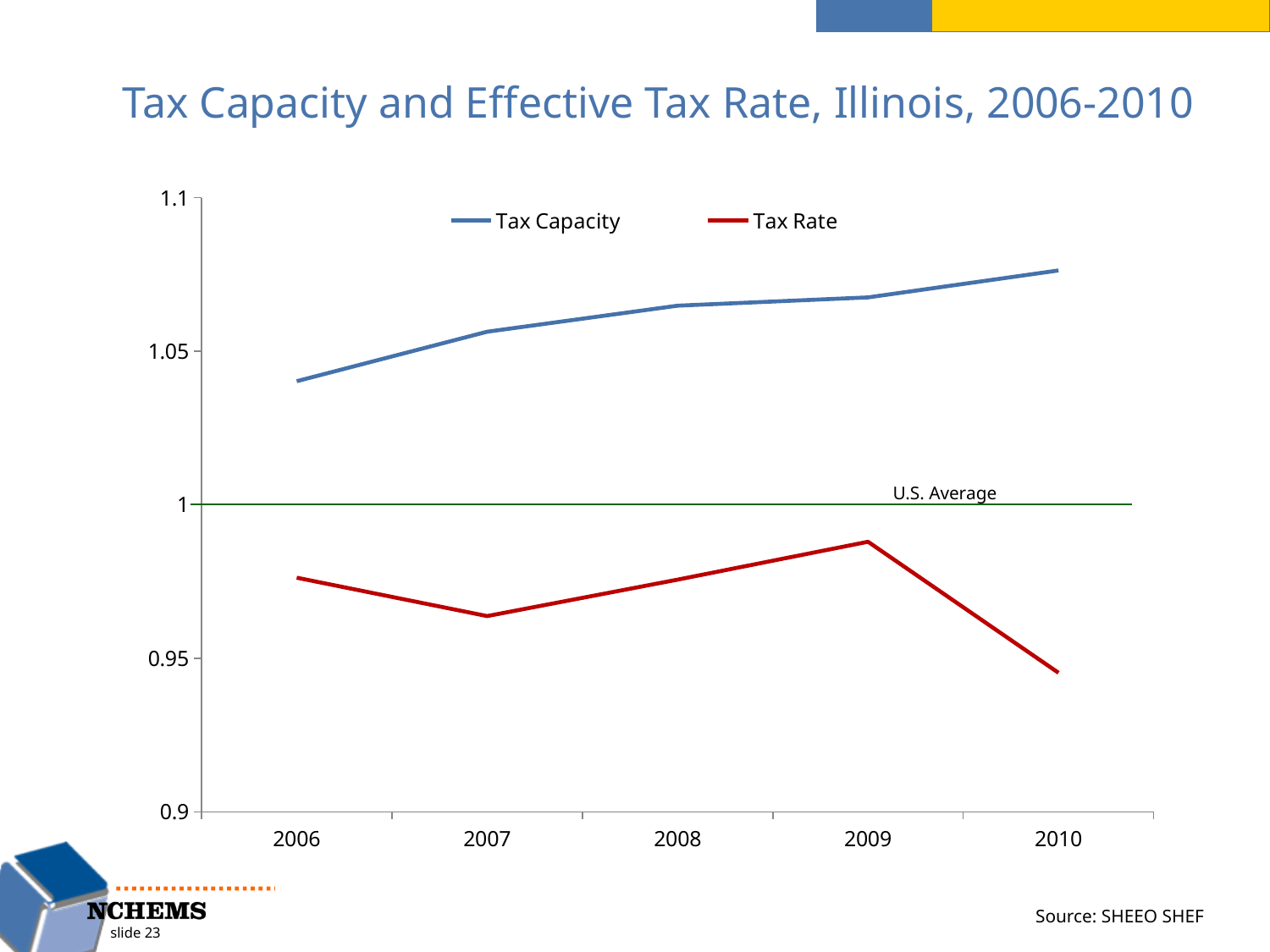
Is the Tax Rate value for 2010 greater or less than 0.95? less How many years are plotted along the x axis? 5 In 2008, which is larger, Tax Capacity or Tax Rate? Tax Capacity In which year is Tax Capacity lowest? 2006 How many series does the legend list? 2 What kind of chart is shown on the slide? Line chart In which year is Tax Capacity highest? 2010 Does the Tax Capacity line rise or fall from 2006 to 2010? Rises Is the Tax Capacity value for 2010 greater or less than 1.05? greater At what value is the U.S. Average reference line drawn? 1 In which year is Tax Rate lowest? 2010 In which year is Tax Rate highest? 2009